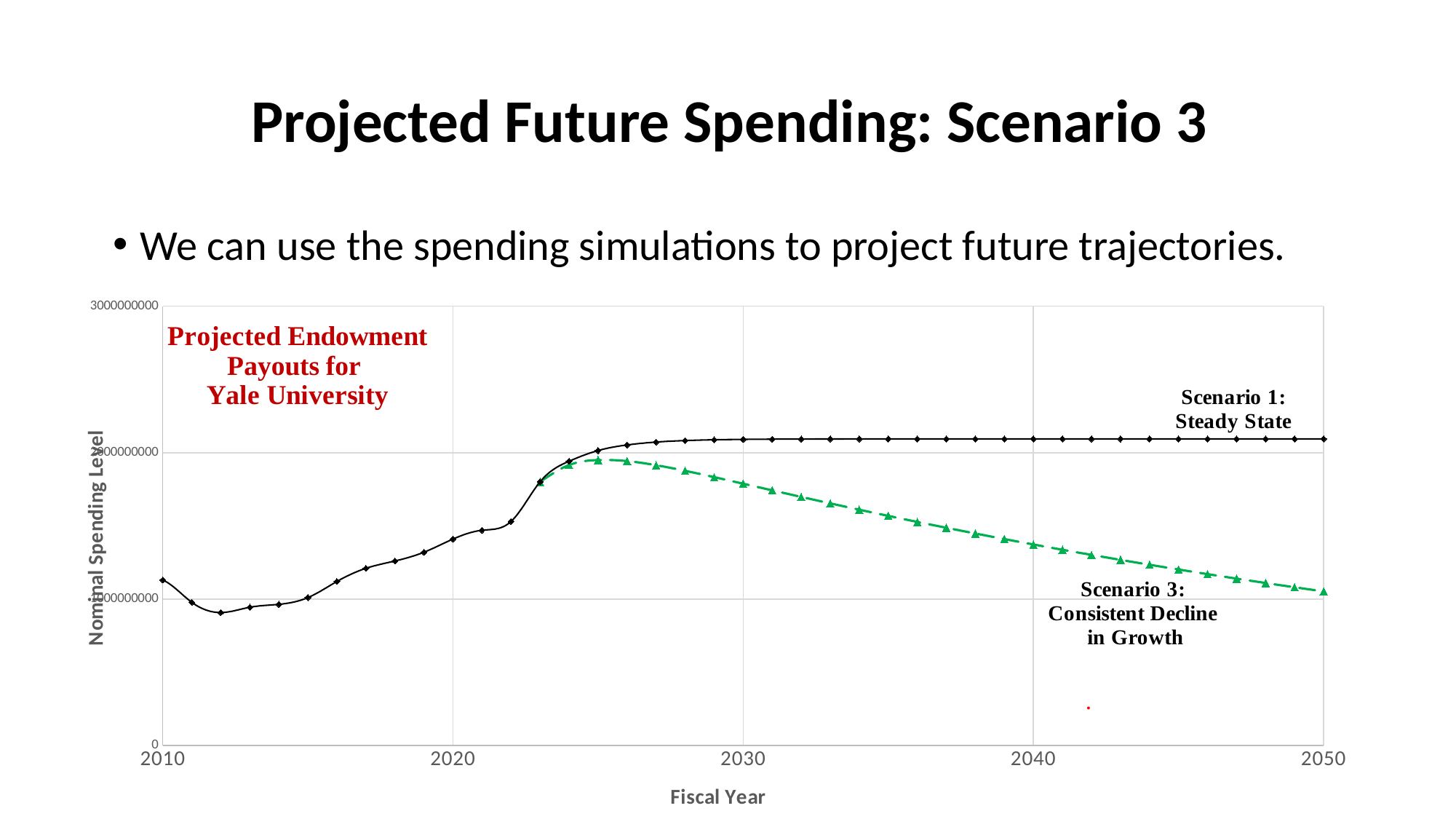
Do the values rise or fall from 2012 to 2025? rise What kind of chart is shown on the slide? line chart How many scenario series are plotted on the chart? 2 Is the value in 2010 greater or less than 2000000000? less Which scenario has the higher value in 2050, Scenario 1: Steady State or Scenario 3: Consistent Decline in Growth? Scenario 1: Steady State Which scenario has the higher value in 2040, Scenario 1: Steady State or Scenario 3: Consistent Decline in Growth? Scenario 1: Steady State Is the value for Scenario 3: Consistent Decline in Growth in 2040 greater or less than 2000000000? less Is the value for Scenario 3: Consistent Decline in Growth in 2040 greater or less than 1000000000? greater What is the title of the chart? Projected Endowment Payouts for Yale University Do the values for Scenario 3: Consistent Decline in Growth rise or fall from 2030 to 2050? fall What is the label of the x axis of the chart? Fiscal Year